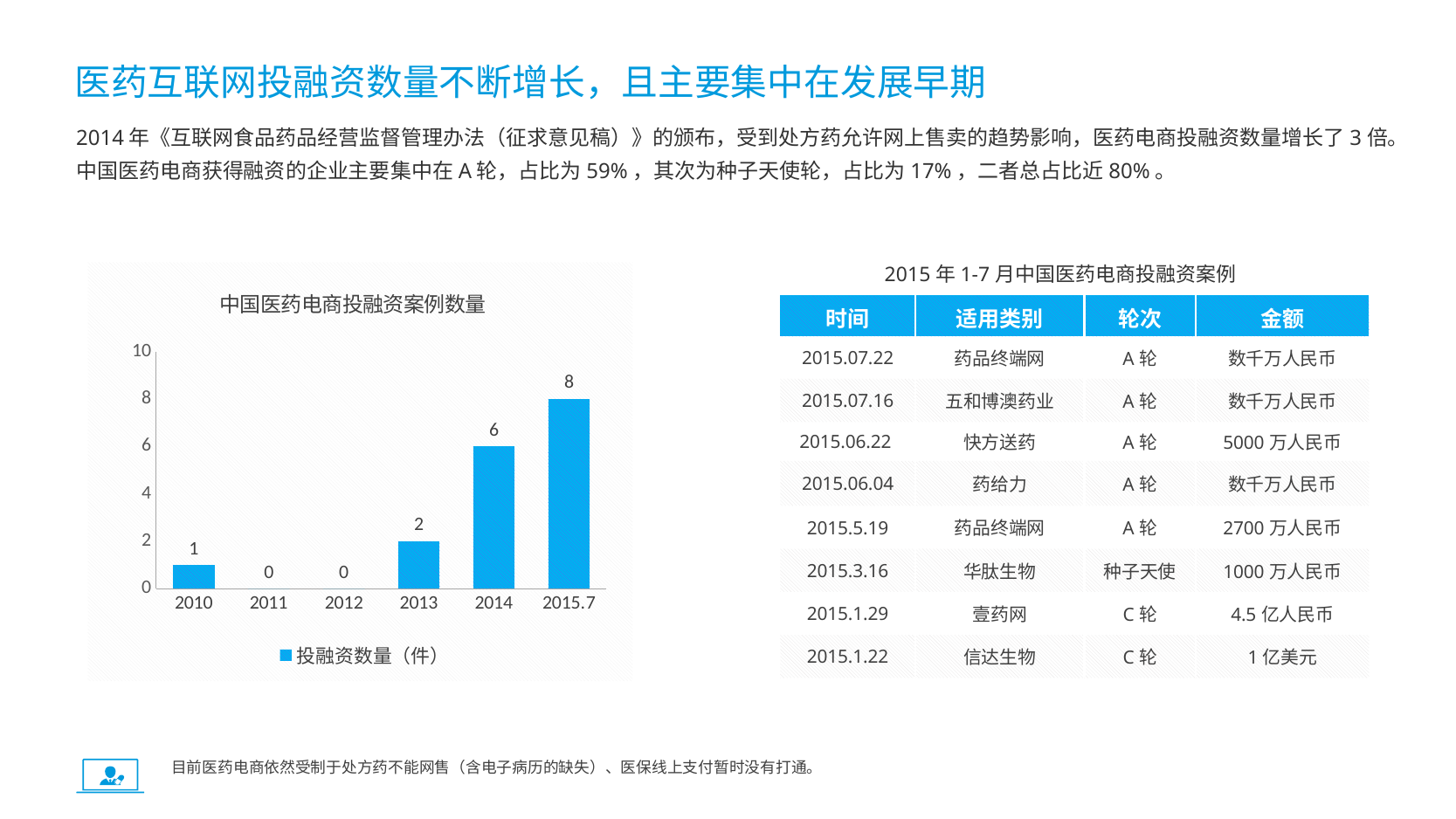
Which is larger in the chart 中国医药电商投融资案例数量, the value for 2013 or the value for 2010? 2013 What is the value for 2013 in the chart 中国医药电商投融资案例数量? 2 What is the difference between the values for 2015.7 and 2014 in the chart 中国医药电商投融资案例数量? 2 How many categories are shown on the x axis of the chart 中国医药电商投融资案例数量? 6 Which category has the highest value in the chart 中国医药电商投融资案例数量? 2015.7 What kind of chart is 中国医药电商投融资案例数量? bar chart What is the value for 2014 in the chart 中国医药电商投融资案例数量? 6 What is the difference between the values for 2014 and 2013 in the chart 中国医药电商投融资案例数量? 4 What is the value for 2010 in the chart 中国医药电商投融资案例数量? 1 What is the value for 2015.7 in the chart 中国医药电商投融资案例数量? 8 What is the legend entry shown in the chart 中国医药电商投融资案例数量? 投融资数量（件） Do the values in the chart 中国医药电商投融资案例数量 rise or fall from 2013 to 2015.7? rise